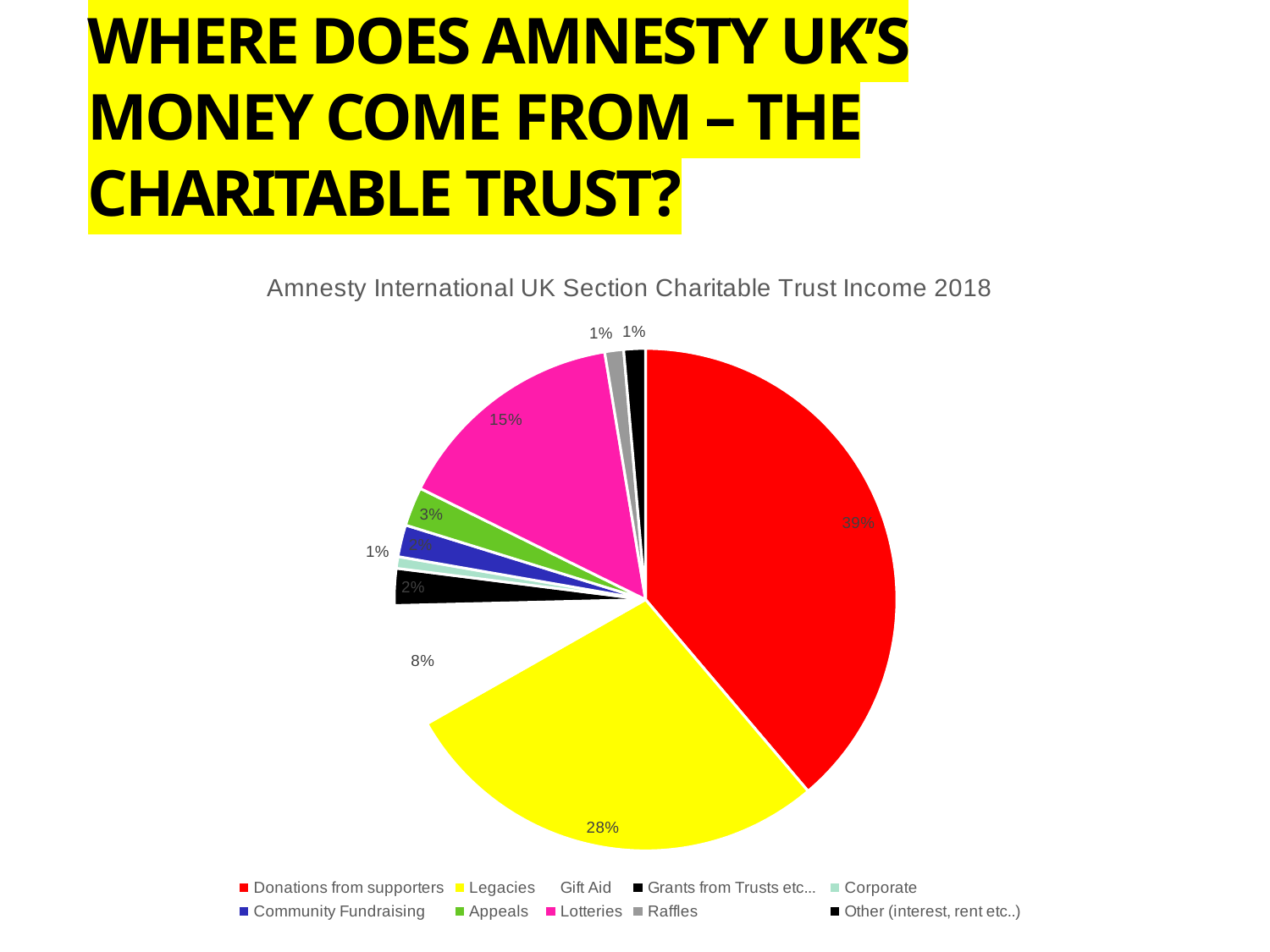
What percentage of income comes from Gift Aid? 8% How many percentage points larger is the Lotteries share than the Appeals share? 12 percentage points What is the title of the chart? Amnesty International UK Section Charitable Trust Income 2018 What percentage of income is from Legacies? 28% What share of income does the Lotteries slice represent? 15% What percentage of income comes from Appeals? 3% Which is larger: the Lotteries share or the Legacies share? Legacies What type of chart is shown on the slide? Pie chart What share of the Charitable Trust income comes from Donations from supporters? 39% How many income categories does the legend list? 10 How many percentage points larger is the Donations from supporters share than the Legacies share? 11 percentage points Which income source has the largest share of the pie? Donations from supporters